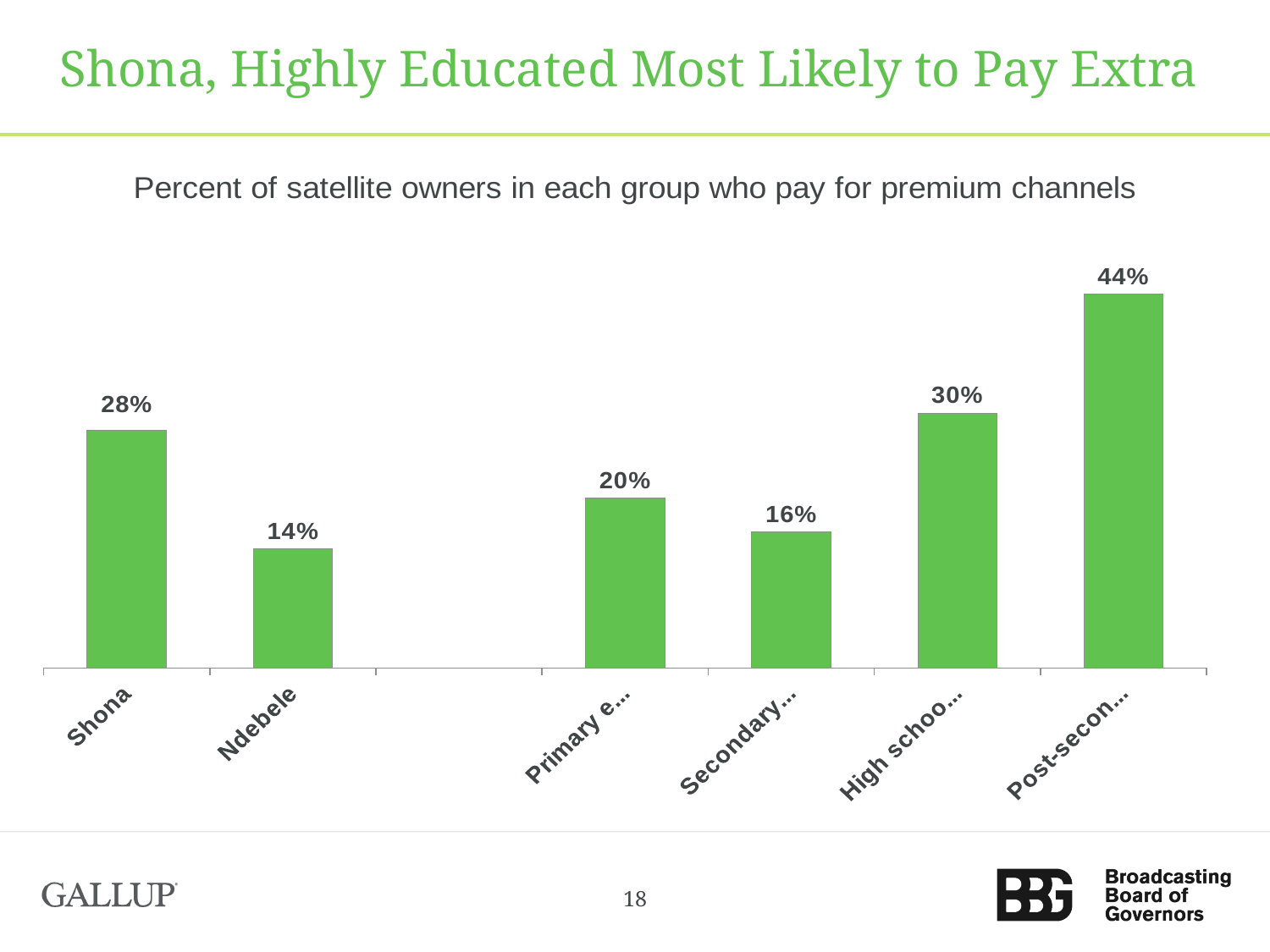
What kind of chart is shown on the slide? Bar chart What is the value shown for Ndebele? 14% What is the difference between the Shona and Ndebele values? 14% Which group has the lowest percentage paying for premium channels? Ndebele What percentage of Shona satellite owners pay for premium channels? 28% What is the value shown for the bar labelled "High schoo..."? 30% What is the subtitle describing what the chart measures? Percent of satellite owners in each group who pay for premium channels How many bars are plotted in the chart? 6 Which is larger, the value for "Primary e..." or the value for "Secondary..."? Primary e... What is the difference between the "Post-secon..." and "High schoo..." values? 14% Which group has the highest percentage paying for premium channels? Post-secon... What is the value shown for the bar labelled "Secondary..."? 16%